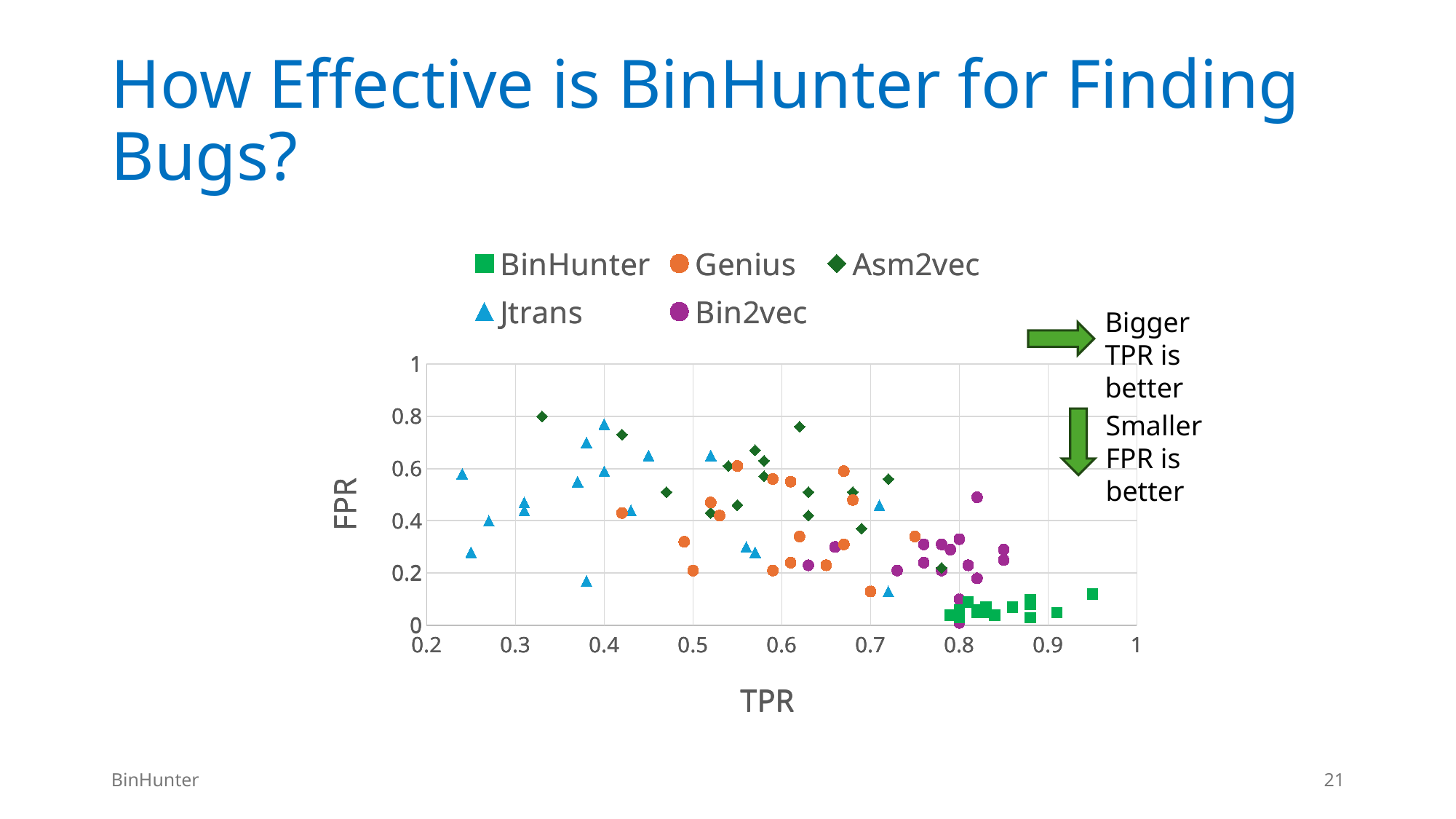
Which series has the points with the lowest FPR values? BinHunter What kind of chart is shown on the slide? Scatter chart Are the FPR values of the BinHunter points greater or less than 0.2? less Which series are listed in the legend? BinHunter, Genius, Asm2vec, Jtrans, Bin2vec What are the labels of the x axis and the y axis? TPR (x axis) and FPR (y axis) Are the TPR values of the BinHunter points greater or less than 0.7? greater How many series does the legend list? 5 Is the TPR of the leftmost Jtrans point greater or less than 0.3? less Which series has the point with the highest TPR value? BinHunter Which series has lower FPR values overall, BinHunter or Asm2vec? BinHunter Overall, do the FPR values rise or fall as TPR increases along the x axis? fall Which series has the points with the lowest TPR values? Jtrans